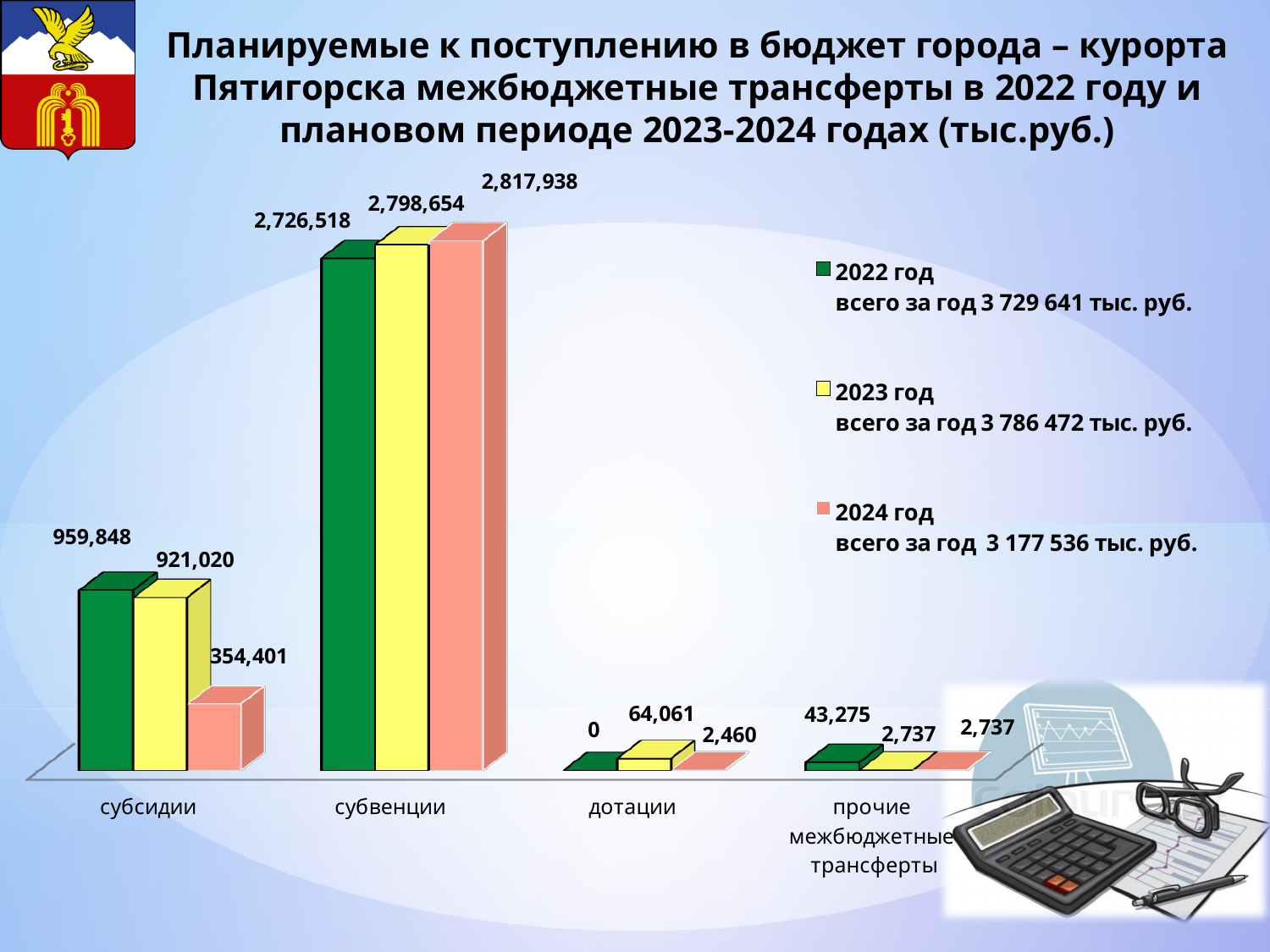
What is the value for дотации in 2023 год? 64,061 What is the difference between the 2024 год and 2022 год values for субвенции? 91,420 Which category has the highest value in 2023 год? субвенции What is the value for прочие межбюджетные трансферты in 2022 год? 43,275 What is the value for субсидии in 2022 год? 959,848 How many series does the legend list? 3 How many categories are shown on the x axis? 4 Which category has the lowest value in 2022 год? дотации What is the value for субвенции in 2024 год? 2,817,938 What kind of chart is shown on the slide? bar chart Which is larger for субсидии: the 2023 год value or the 2024 год value? 2023 год What is the difference between the 2022 год and 2023 год values for субсидии? 38,828